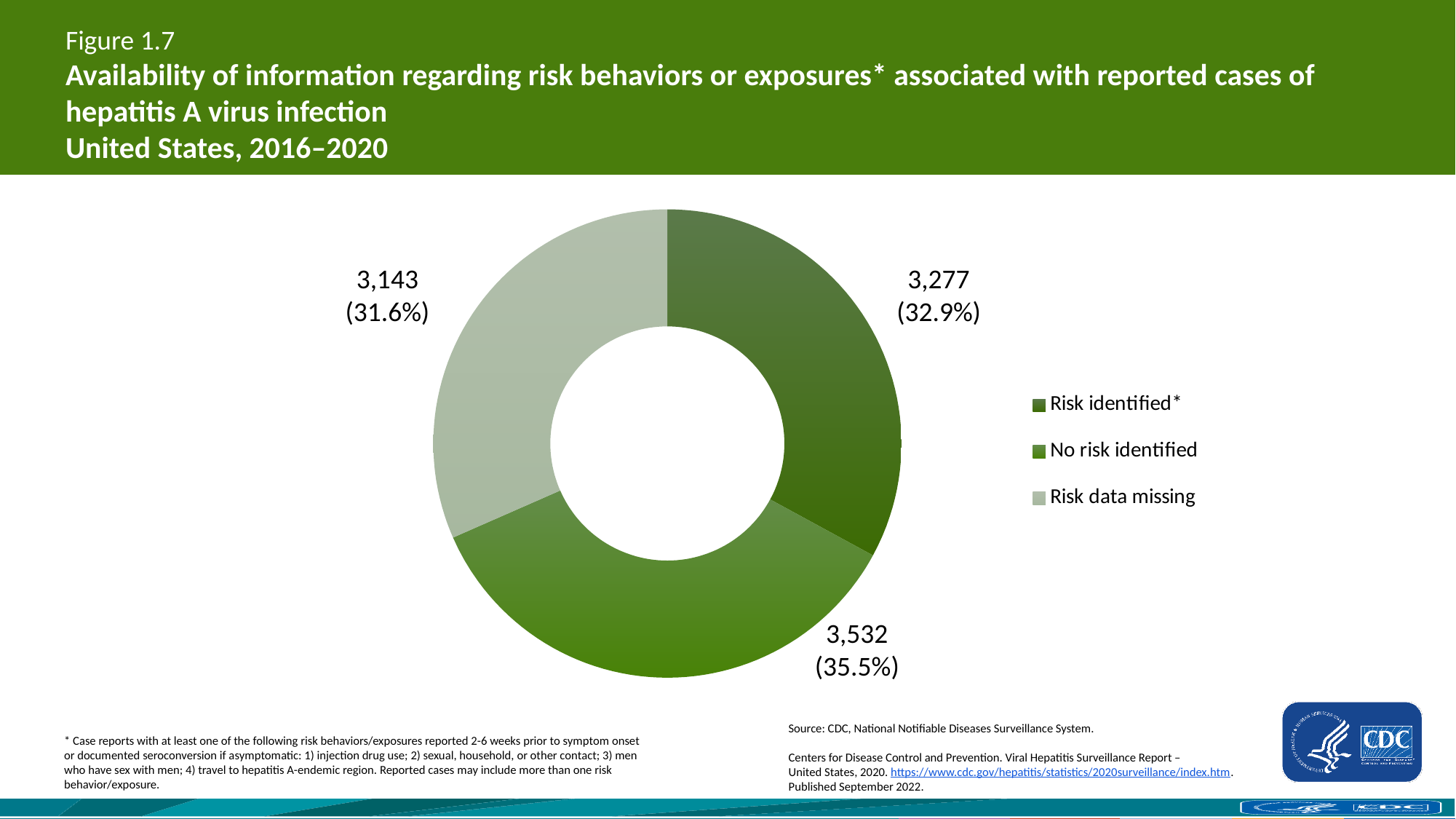
Which category has the smallest number of cases? Risk data missing Which legend entry is shown in the lightest green colour? Risk data missing What is the difference in cases between "No risk identified" and "Risk identified"? 255 Which category has the largest number of cases? No risk identified What is the total number of cases across all three categories? 9,952 How many cases fall in the "Risk data missing" category? 3,143 How many reported cases had a risk identified? 3,277 How many categories does the chart show? 3 Which is larger: the number of cases with risk identified or the number with risk data missing? Risk identified What percentage of cases had risk data missing? 31.6% What share of cases is shown for "No risk identified"? 35.5% What kind of chart is shown on the slide? Pie chart (donut)